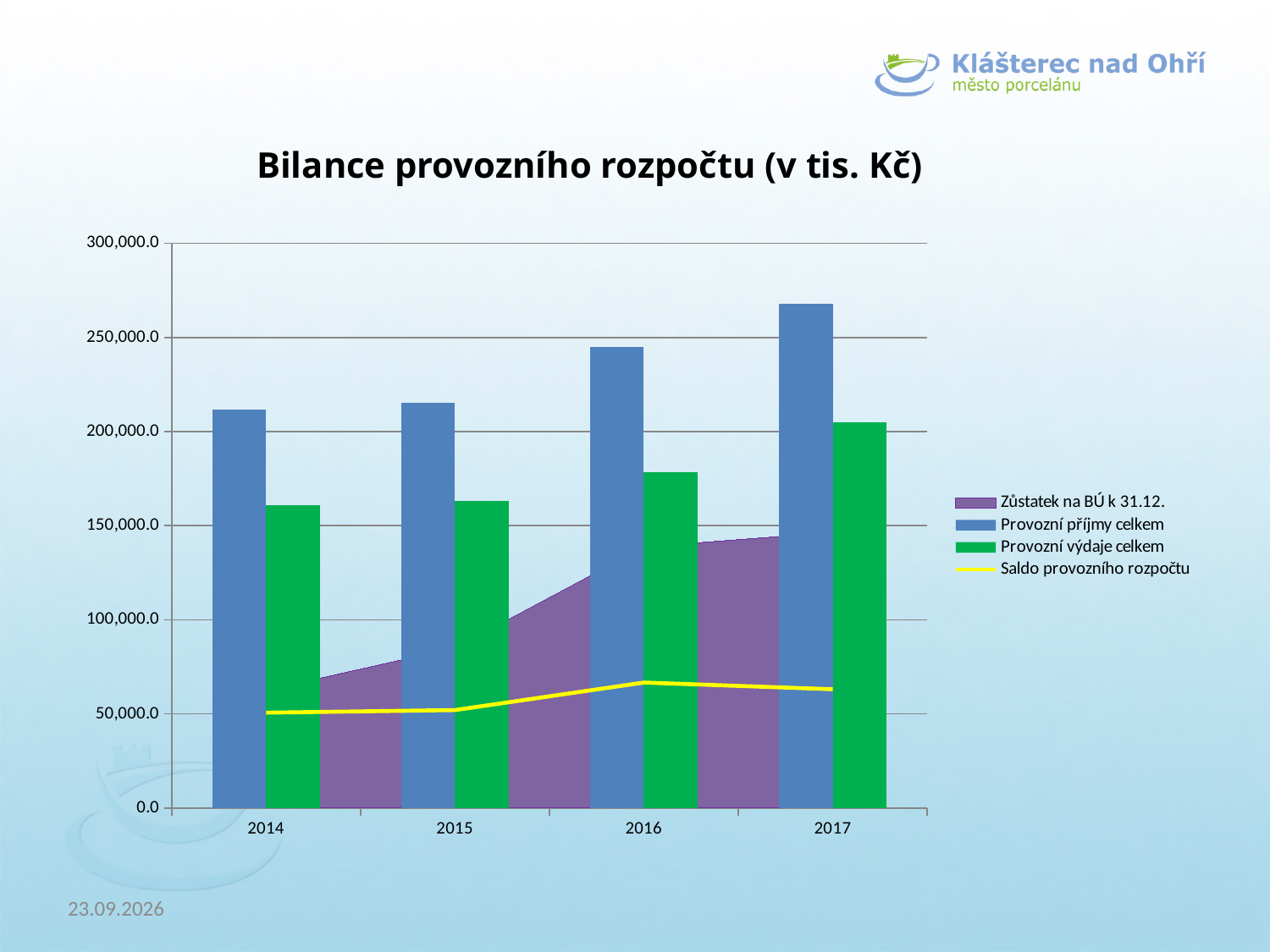
How many years are shown on the x axis? 4 Is the value of Provozní příjmy celkem for 2017 greater or less than 250,000.0? greater In which year is Provozní výdaje celkem highest? 2017 How many series does the legend list? 4 In 2016, which is larger: Provozní příjmy celkem or Provozní výdaje celkem? Provozní příjmy celkem Which series is drawn as a yellow line? Saldo provozního rozpočtu Is the value of Provozní příjmy celkem for 2014 greater or less than 200,000.0? greater In which year is Provozní příjmy celkem highest? 2017 Do the values of Provozní příjmy celkem rise or fall from 2014 to 2017? rise Is the value of Provozní výdaje celkem for 2016 greater or less than 200,000.0? less What is the title of the chart? Bilance provozního rozpočtu (v tis. Kč) In which year is Provozní příjmy celkem lowest? 2014